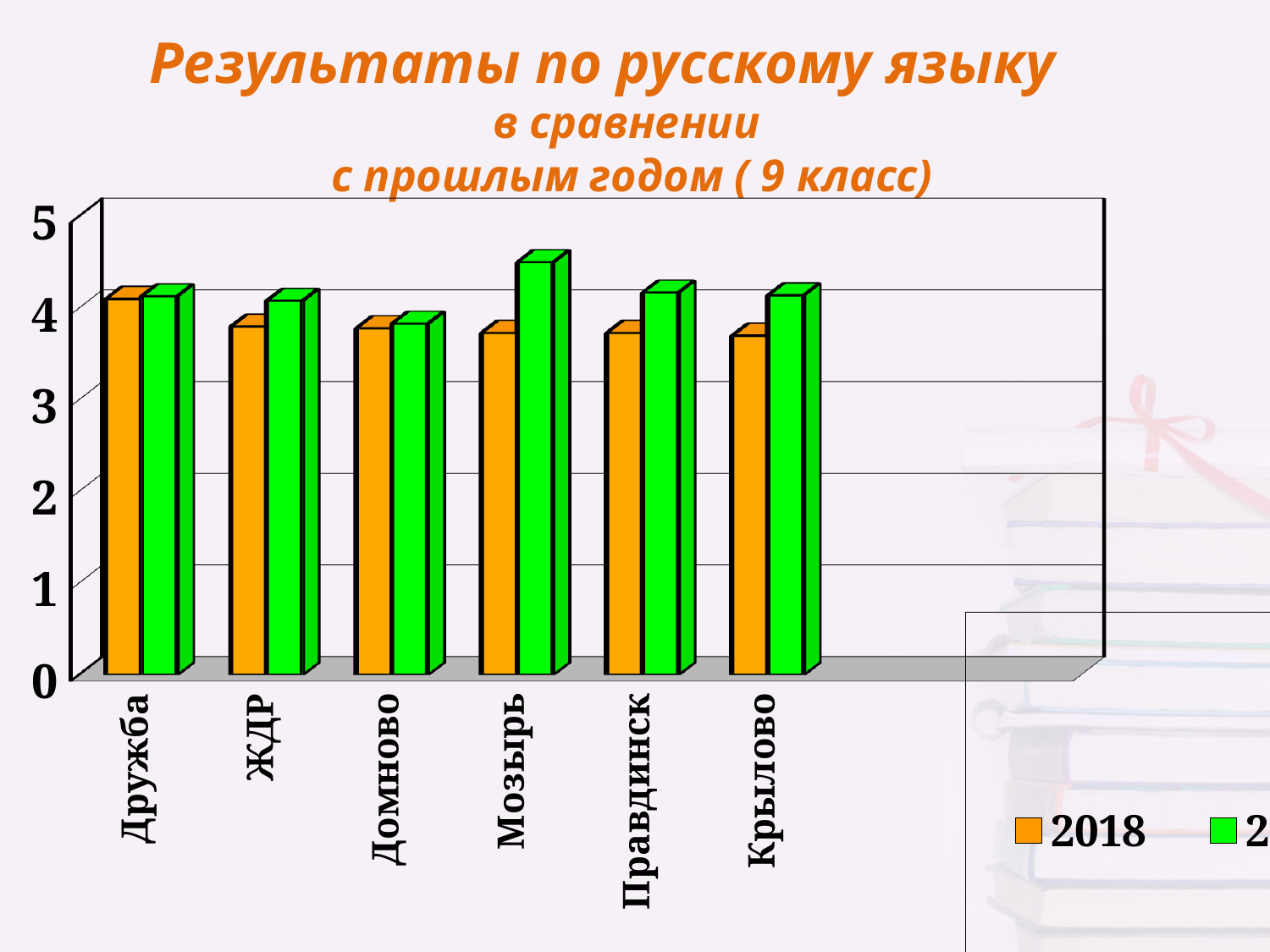
Is the 2018 value for Правдинск greater or less than 3? greater Which category has the highest 2018 bar? Дружба What kind of chart is shown on the slide? bar chart How many categories (schools) are shown on the x axis of the chart? 6 Is the 2018 value for ЖДР greater or less than 4? less What colour are the bars for the 2018 series? orange How many series does the chart's legend list? 2 Is the green (second series) value for Мозырь greater or less than 4? greater Which category has the highest green (second series) bar? Мозырь For Мозырь, which bar is taller: the 2018 bar or the green (second series) bar? the green (second series) bar For Правдинск, which bar is taller: the 2018 bar or the green (second series) bar? the green (second series) bar